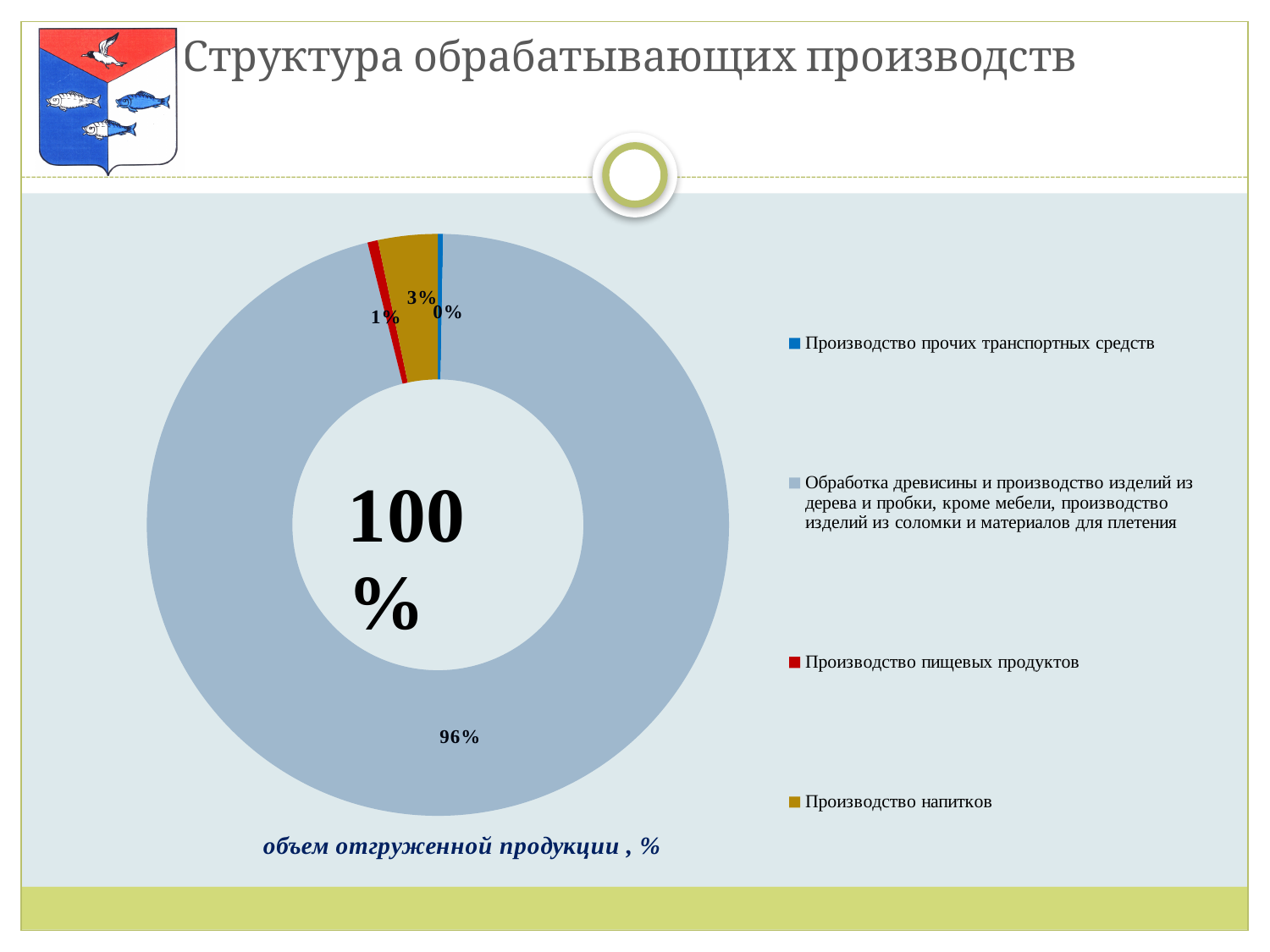
What share of the chart does "Производство напитков" have? 3% What is the difference in percentage points between the share of "Производство напитков" and the share of "Производство пищевых продуктов"? 2 Which category has the smallest share of the chart? Производство прочих транспортных средств What text is shown in the centre of the doughnut chart? 100% What share of the chart does "Обработка древесины и производство изделий из дерева и пробки, кроме мебели, производство изделий из соломки и материалов для плетения" have? 96% How many categories does the legend of the chart list? 4 What share of the chart does "Производство пищевых продуктов" have? 1% What share of the chart does "Производство прочих транспортных средств" have? 0% What kind of chart is shown on the slide? doughnut (pie) chart What caption is written below the chart? объем отгруженной продукции , % Which has a larger share: "Производство напитков" or "Производство пищевых продуктов"? Производство напитков Which category has the largest share of the chart? Обработка древисины и производство изделий из дерева и пробки, кроме мебели, производство изделий из соломки и материалов для плетения